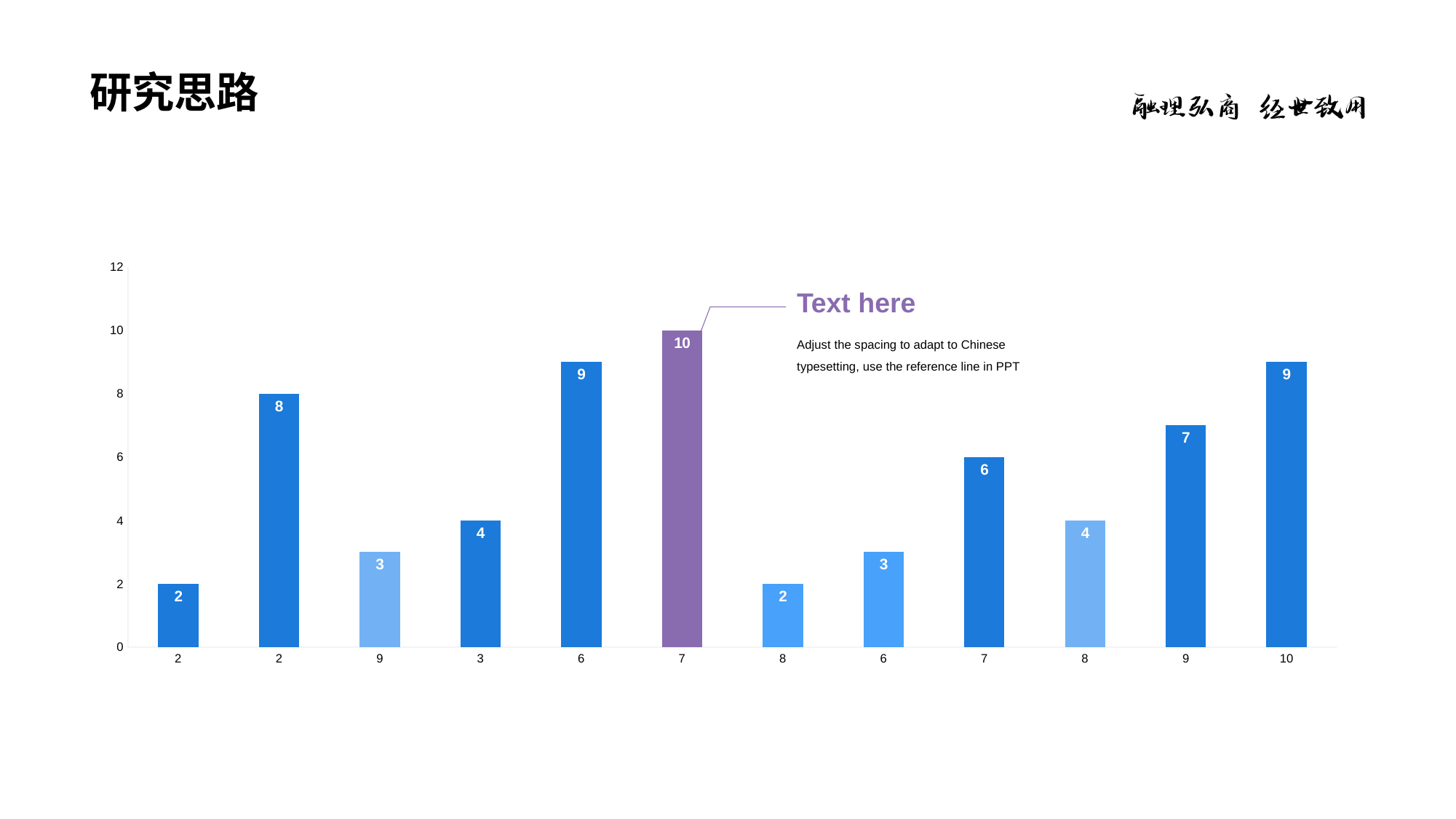
What is the lowest value shown in the chart? 2 What is the text of the callout label pointing to the purple bar? Text here What is the difference between the value of the purple bar and the value of the bar labelled 3? 6 What is the value of the second bar from the left in the chart? 8 What is the value of the bar labelled 10 on the x axis? 9 How many bars are plotted in the chart? 12 What type of chart is shown on the slide? bar chart What is the value of the bar labelled 3 on the x axis? 4 Which is larger: the value of the bar labelled 10 or the value of the bar labelled 3? the bar labelled 10 What is the value of the purple bar in the chart? 10 What is the value of the first (leftmost) bar in the chart? 2 What is the highest value shown in the chart? 10